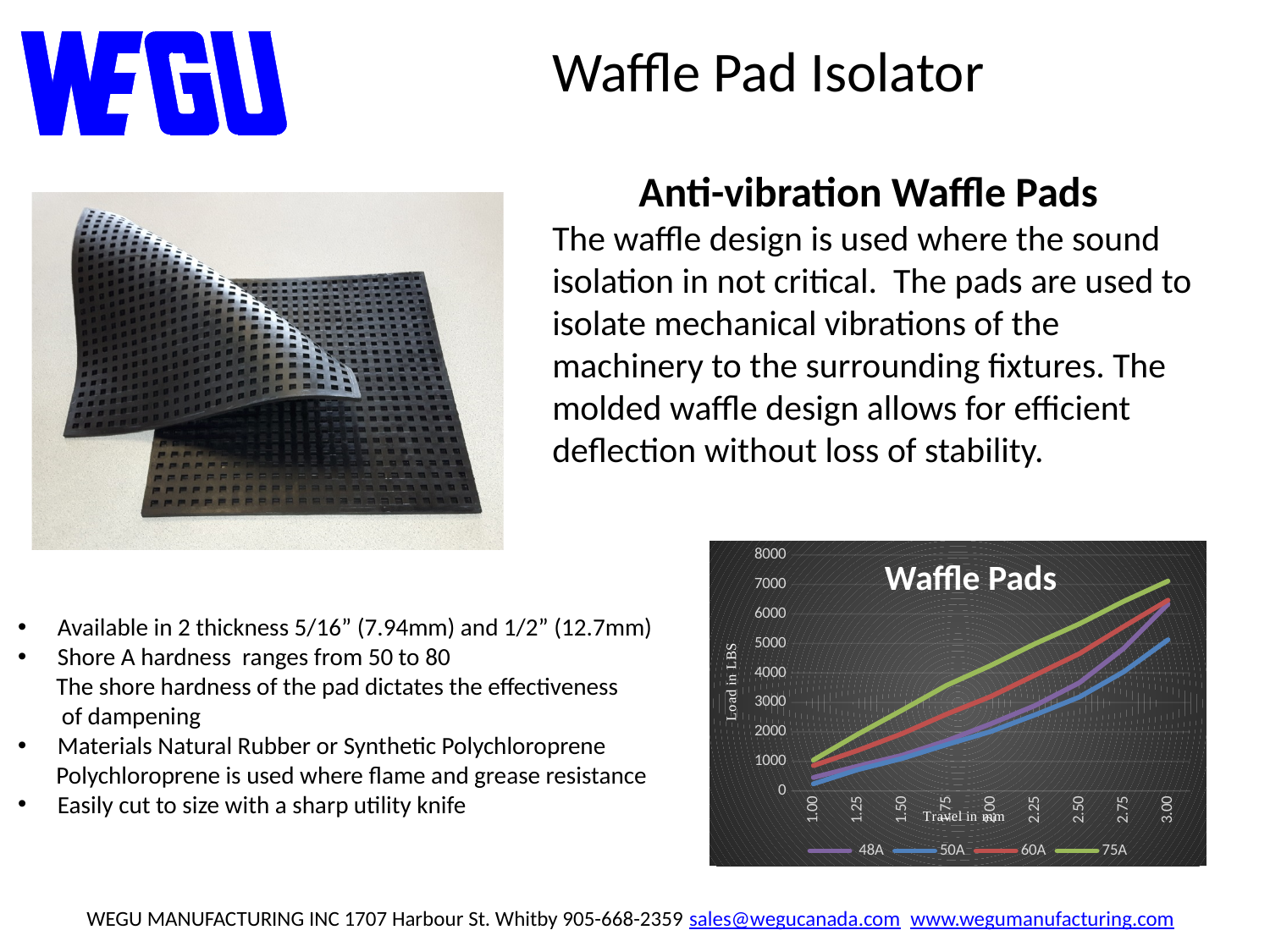
What are the series names listed in the legend of the Waffle Pads chart? 48A, 50A, 60A, 75A In the Waffle Pads chart, at 3.00 mm of travel, which series has the larger load, 75A or 50A? 75A In the Waffle Pads chart, is the load for 48A at 1.00 mm greater or less than 1000? less In the Waffle Pads chart, which series has the lowest load at 3.00 mm of travel? 50A How many series does the legend of the Waffle Pads chart list? 4 In the Waffle Pads chart, is the load for 50A at 3.00 mm greater or less than 6000? less In the Waffle Pads chart, which series has the highest load at 3.00 mm of travel? 75A In the Waffle Pads chart, is the load for 75A at 3.00 mm greater or less than 6000? greater In the Waffle Pads chart, does the load for the 75A series rise or fall as travel increases from 1.00 to 3.00 mm? rise What kind of chart is the Waffle Pads chart? line chart How many travel values are marked on the x axis of the Waffle Pads chart? 9 What is the title of the chart on the slide? Waffle Pads